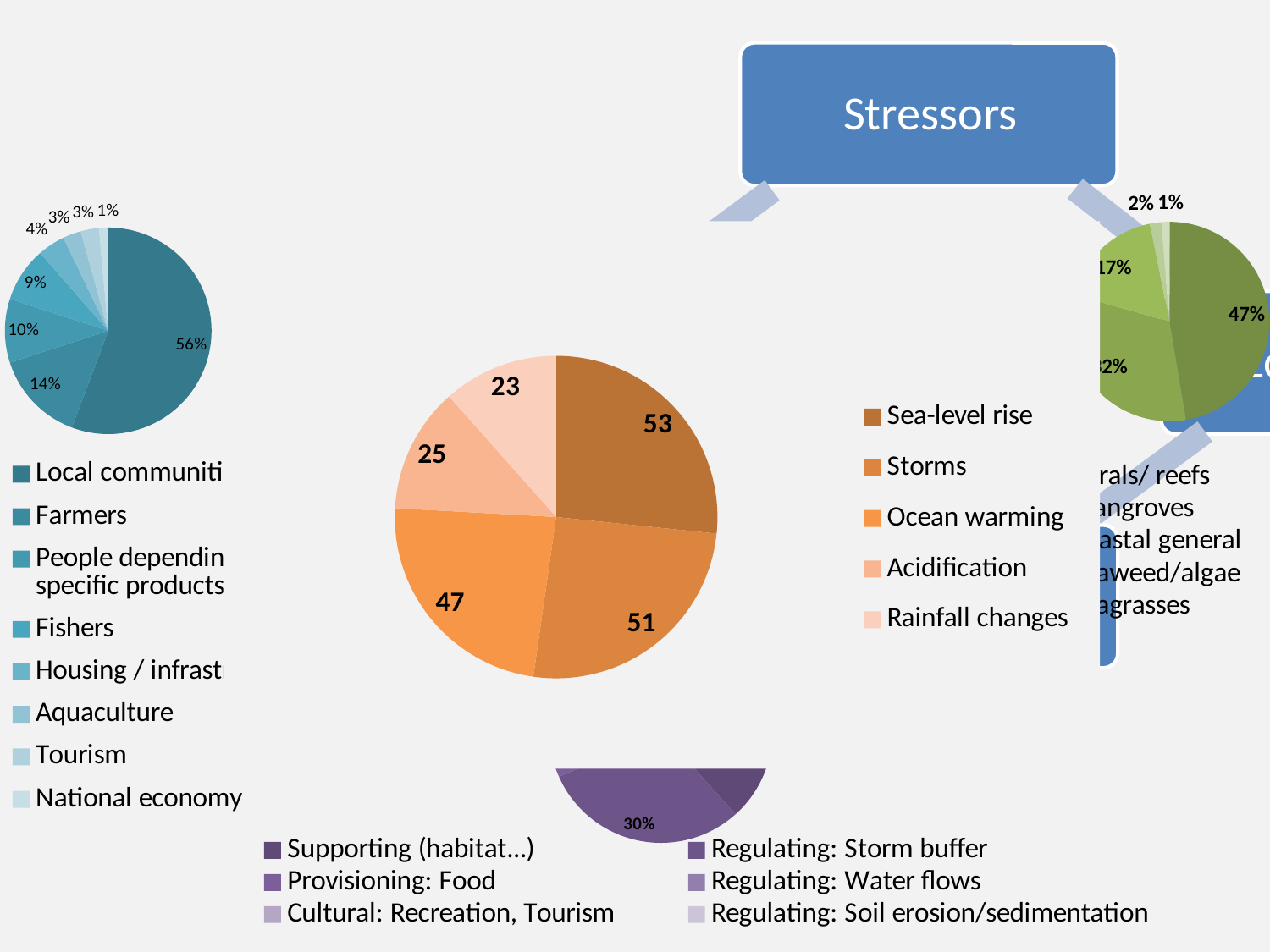
In the pie chart on the left of the slide, what percentage is shown for Farmers? 14% In the Stressors pie chart in the centre of the slide, which stressor has the highest value? Sea-level rise In the Stressors pie chart in the centre of the slide, what is the value for Sea-level rise? 53 How many categories does the legend of the pie chart on the left of the slide list? 8 In the pie chart on the left of the slide, what percentage is shown for the largest slice (Local communities)? 56% In the pie chart on the left of the slide, which category has the smallest share? National economy In the Stressors pie chart in the centre of the slide, which stressor has the lowest value? Rainfall changes In the Stressors pie chart in the centre of the slide, what is the value for Acidification? 25 In the Stressors pie chart in the centre of the slide, which is larger: Ocean warming or Acidification? Ocean warming What type of chart is the central chart under the Stressors heading? Pie chart In the Stressors pie chart in the centre of the slide, what is the difference between the values for Sea-level rise and Rainfall changes? 30 How many stressors does the legend of the central Stressors pie chart list? 5